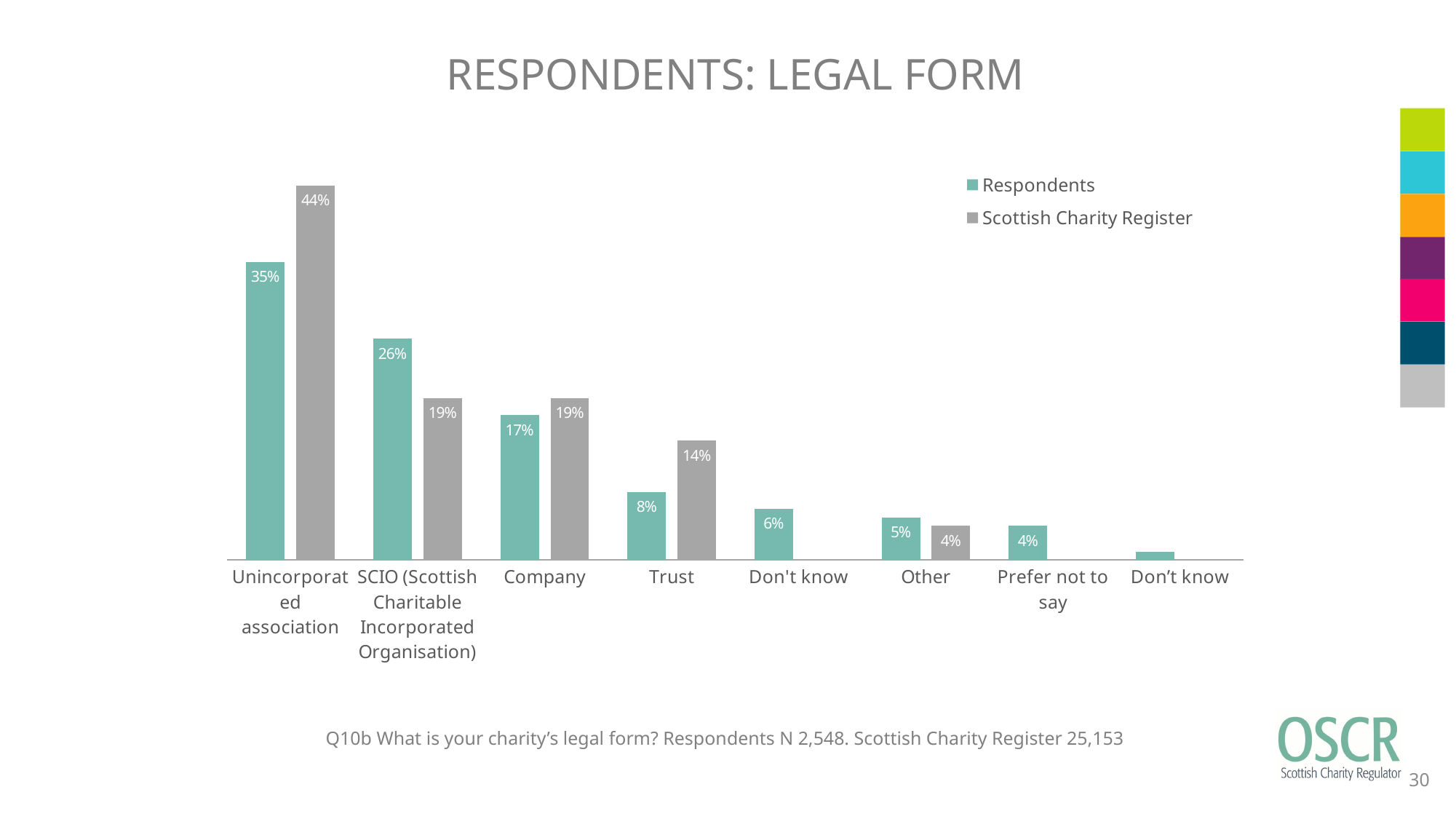
What is the Scottish Charity Register value for Unincorporated association? 44% What is the Respondents value for Prefer not to say? 4% What is the Respondents value for SCIO (Scottish Charitable Incorporated Organisation)? 26% What is the difference between the Respondents and Scottish Charity Register values for SCIO (Scottish Charitable Incorporated Organisation)? 7% Which category has the highest Scottish Charity Register value? Unincorporated association For Company, which series has the larger value, Respondents or Scottish Charity Register? Scottish Charity Register What is the Scottish Charity Register value for Trust? 14% For Trust, which series has the larger value, Respondents or Scottish Charity Register? Scottish Charity Register What is the difference between the Scottish Charity Register and Respondents values for Unincorporated association? 9% What kind of chart is shown on the slide? Bar chart What is the Respondents value for Unincorporated association? 35% How many series does the legend list? 2